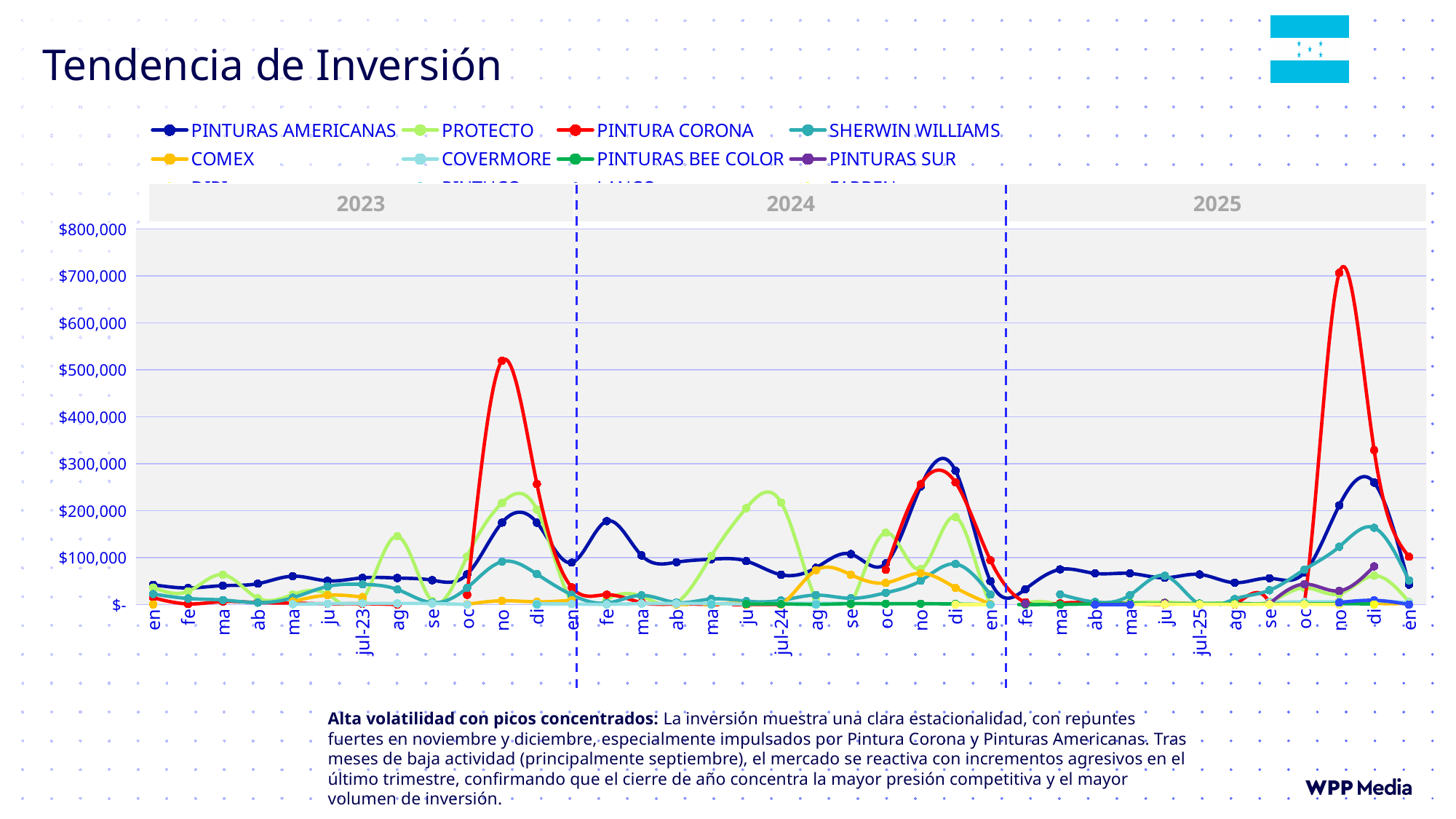
Which series reaches the highest peak on the chart? PINTURA CORONA Is the value for PINTURA CORONA in November 2023 greater or less than $400,000? greater Which series has the highest value in July 2024 (jul-24)? PROTECTO Is the value for PINTURA CORONA in November 2025 greater or less than $600,000? greater What is the title of the chart? Tendencia de Inversión Is the value for PINTURAS AMERICANAS in December 2024 greater or less than $200,000? greater In November 2023, which series has the higher value, PINTURA CORONA or PINTURAS AMERICANAS? PINTURA CORONA What kind of chart is shown on the slide? Line chart In December 2025, which series has the higher value, PINTURA CORONA or SHERWIN WILLIAMS? PINTURA CORONA Does the PINTURA CORONA line rise or fall from November 2025 to January 2026? Fall How many year bands are shown across the top of the chart? 3